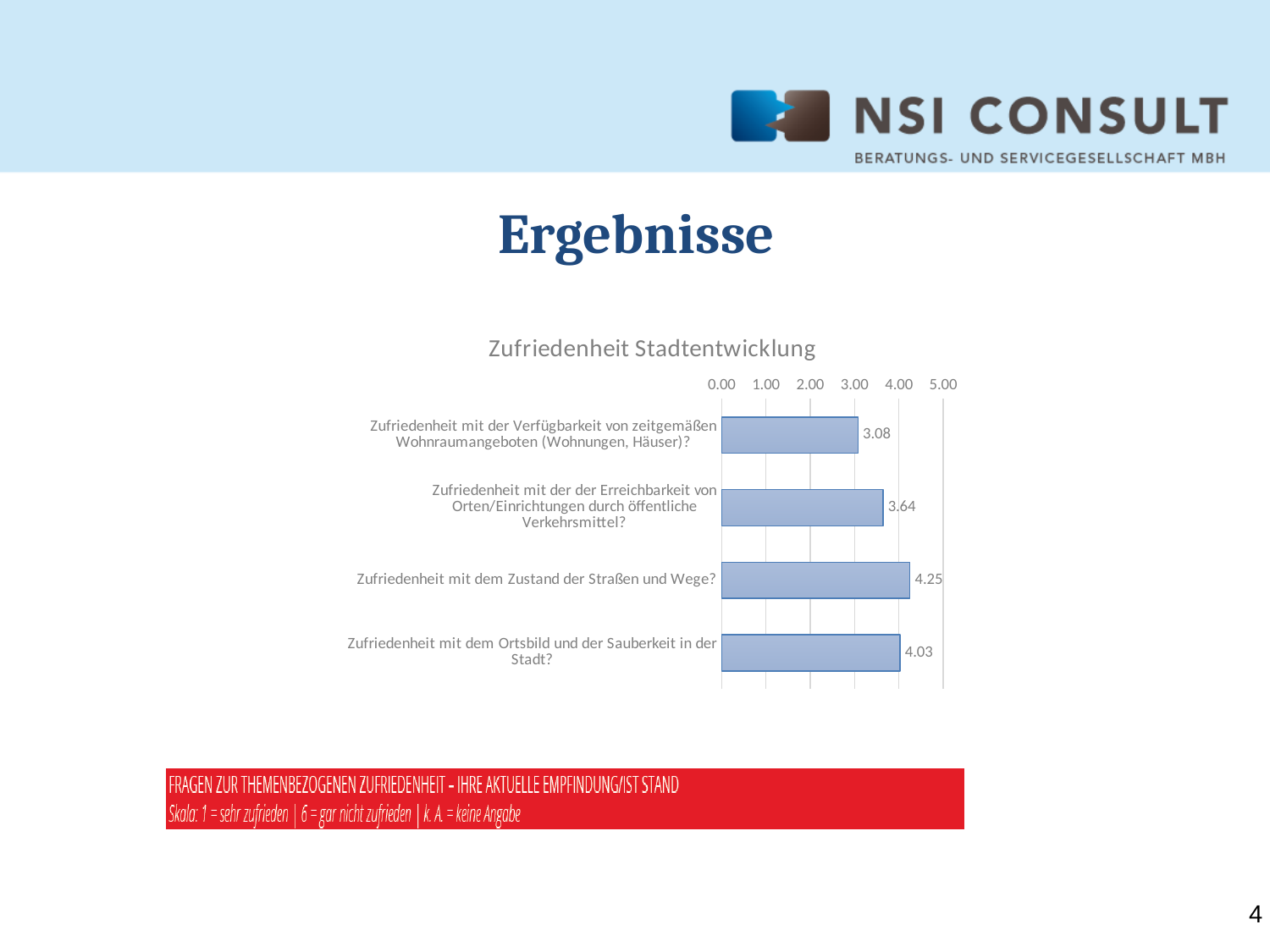
What is the difference between the values for 'Zufriedenheit mit dem Zustand der Straßen und Wege?' and 'Zufriedenheit mit der Verfügbarkeit von zeitgemäßen Wohnraumangeboten (Wohnungen, Häuser)?'? 1.17 What is the value for 'Zufriedenheit mit der der Erreichbarkeit von Orten/Einrichtungen durch öffentliche Verkehrsmittel?'? 3.64 What is the title of the chart? Zufriedenheit Stadtentwicklung Which category has the highest value? Zufriedenheit mit dem Zustand der Straßen und Wege? How many categories are shown in the chart? 4 Is the value for 'Zufriedenheit mit der der Erreichbarkeit von Orten/Einrichtungen durch öffentliche Verkehrsmittel?' greater or less than 4.00? less Which category has the lowest value? Zufriedenheit mit der Verfügbarkeit von zeitgemäßen Wohnraumangeboten (Wohnungen, Häuser)? What is the value for 'Zufriedenheit mit dem Ortsbild und der Sauberkeit in der Stadt?'? 4.03 What is the value for 'Zufriedenheit mit dem Zustand der Straßen und Wege?'? 4.25 What is the value for 'Zufriedenheit mit der Verfügbarkeit von zeitgemäßen Wohnraumangeboten (Wohnungen, Häuser)?'? 3.08 What kind of chart is shown on the slide? bar chart Which is larger: the value for 'Zufriedenheit mit dem Ortsbild und der Sauberkeit in der Stadt?' or for 'Zufriedenheit mit der der Erreichbarkeit von Orten/Einrichtungen durch öffentliche Verkehrsmittel?'? Zufriedenheit mit dem Ortsbild und der Sauberkeit in der Stadt?